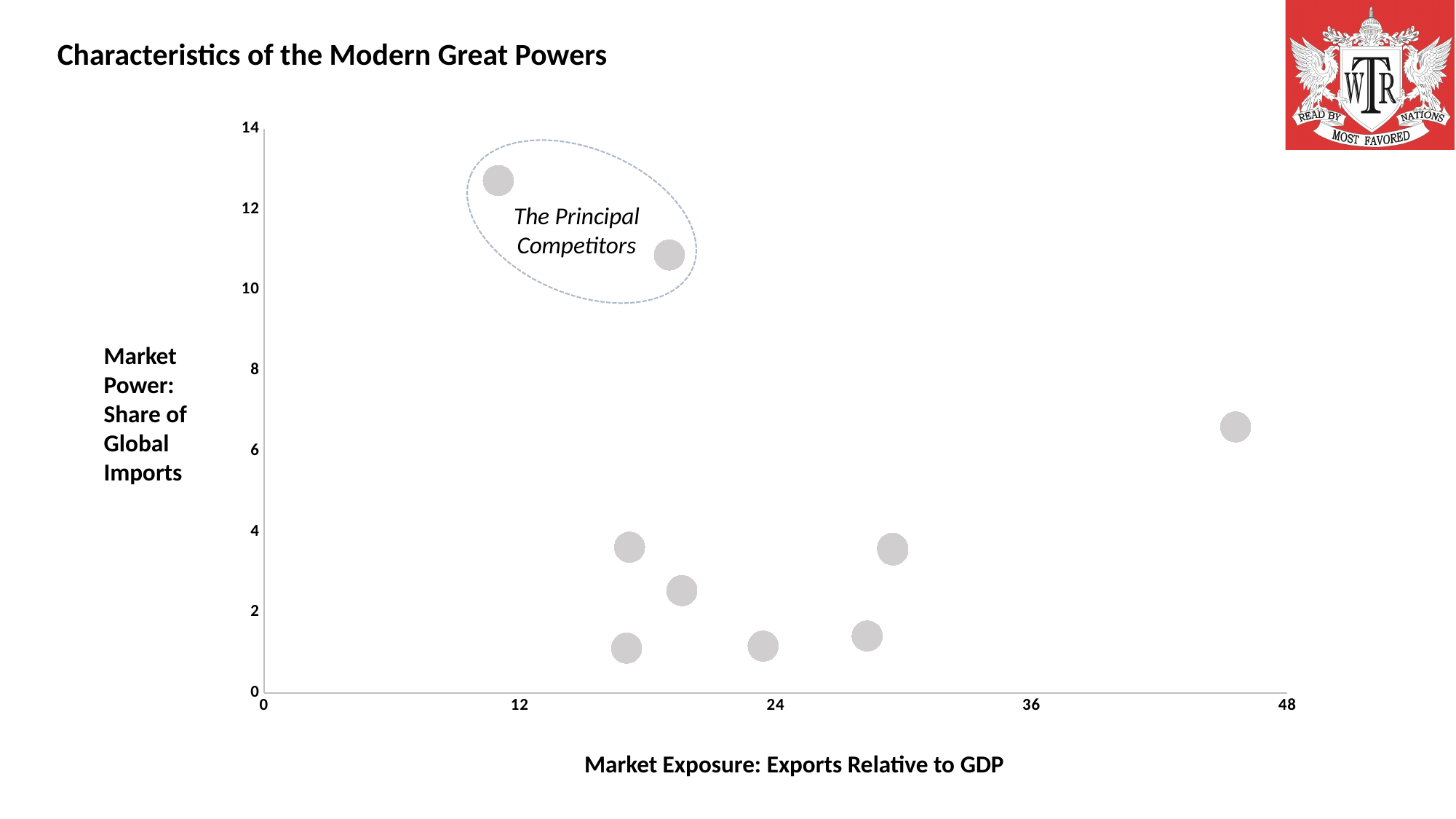
Is the share of global imports for the lower point inside the dashed ellipse greater or less than 10? greater How many data points are enclosed by the dashed ellipse labelled 'The Principal Competitors'? 2 Are the exports-relative-to-GDP values for the two points inside the dashed ellipse greater or less than 24? less What kind of chart is shown on the slide? scatter chart Which has the higher share of global imports: the rightmost point or the cluster of points near the bottom of the chart? the rightmost point What text is written inside the dashed ellipse on the chart? The Principal Competitors Is the share of global imports for the rightmost point greater or less than 6? greater Where on the chart is the point with the highest share of global imports located? upper left, inside the dashed ellipse What is the title of the horizontal axis? Market Exposure: Exports Relative to GDP